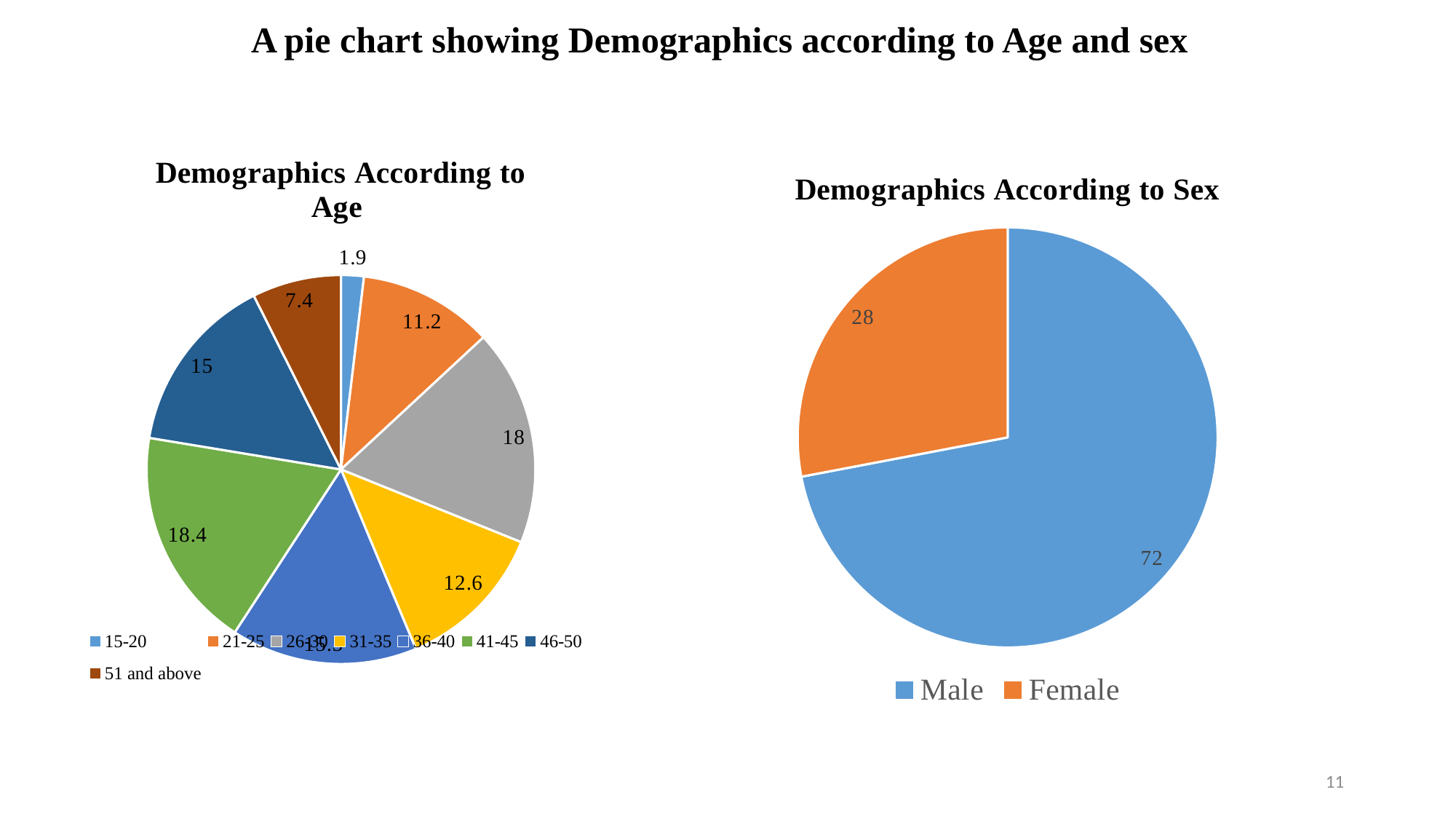
In the Demographics According to Sex chart, what is the difference between the Male and Female values? 44 In the Demographics According to Age chart, which is larger, the value for 21-25 or the value for 46-50? 46-50 In the Demographics According to Age chart, what is the value for the 26-30 age group? 18 What kind of chart is the Demographics According to Sex chart? Pie chart In the Demographics According to Age chart, what is the difference between the values for 41-45 and 31-35? 5.8 How many categories does the legend of the Demographics According to Age chart list? 8 In the Demographics According to Age chart, what is the value for the 21-25 age group? 11.2 In the Demographics According to Age chart, what is the value for the 51 and above group? 7.4 In the Demographics According to Sex chart, what is the value for Female? 28 In the Demographics According to Sex chart, which category has the larger share? Male In the Demographics According to Age chart, what is the value for the 46-50 age group? 15 In the Demographics According to Age chart, which age group has the smallest slice? 15-20